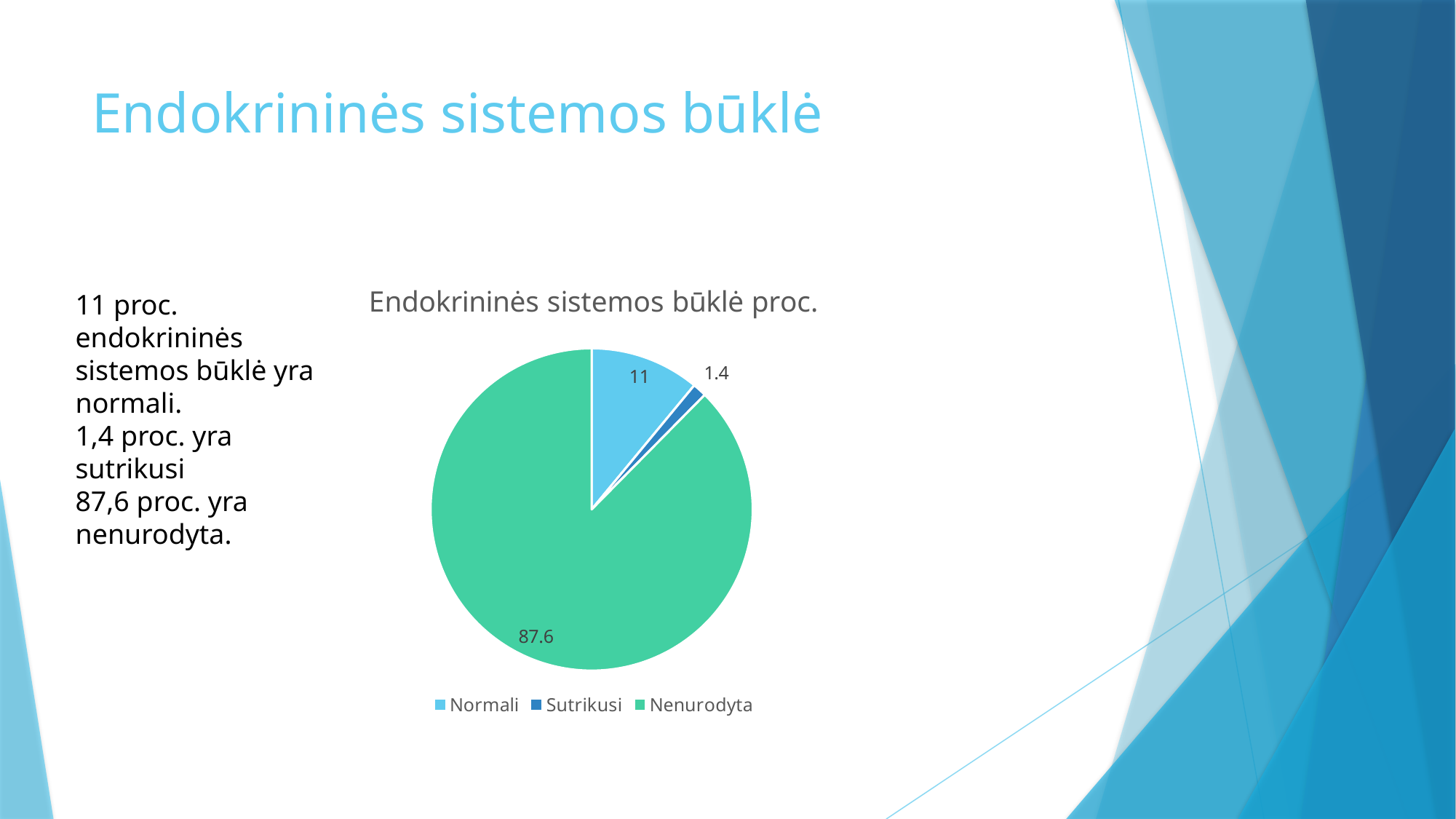
What is the title of the chart? Endokrininės sistemos būklė proc. What is the value for Sutrikusi in the pie chart? 1.4 Which is larger, the value for Normali or the value for Sutrikusi? Normali What is the value for Nenurodyta in the pie chart? 87.6 What colour is the Nenurodyta slice in the pie chart? green Which category has the largest slice in the pie chart? Nenurodyta What is the value for Normali in the pie chart? 11 What kind of chart is shown on the slide? pie chart What is the difference between the values for Nenurodyta and Normali? 76.6 Which category has the smallest slice in the pie chart? Sutrikusi How many categories does the pie chart show? 3 What is the difference between the values for Normali and Sutrikusi? 9.6